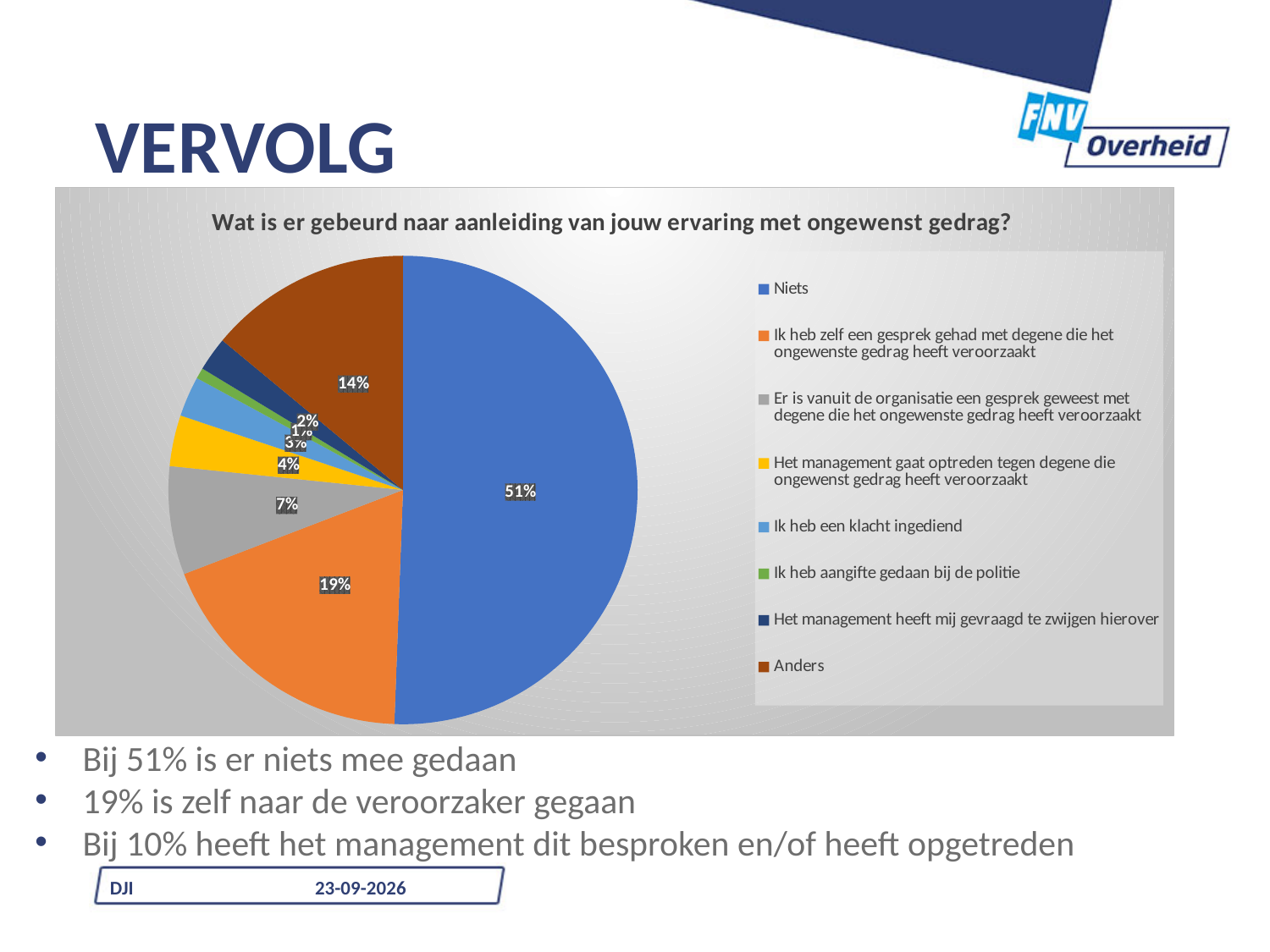
What percentage of the pie is 'Niets'? 51% How many categories does the legend of the pie chart list? 8 What is the title of the chart? Wat is er gebeurd naar aanleiding van jouw ervaring met ongewenst gedrag? What percentage is shown for 'Het management gaat optreden tegen degene die ongewenst gedrag heeft veroorzaakt'? 4% What percentage is shown for 'Ik heb zelf een gesprek gehad met degene die het ongewenste gedrag heeft veroorzaakt'? 19% Which category has the largest share of the pie? Niets What percentage is shown for 'Er is vanuit de organisatie een gesprek geweest met degene die het ongewenste gedrag heeft veroorzaakt'? 7% What is the difference in percentage points between 'Niets' and 'Ik heb zelf een gesprek gehad met degene die het ongewenste gedrag heeft veroorzaakt'? 32 What percentage is shown for 'Het management heeft mij gevraagd te zwijgen hierover'? 2% Which has a larger share: 'Anders' or 'Er is vanuit de organisatie een gesprek geweest met degene die het ongewenste gedrag heeft veroorzaakt'? Anders What percentage is shown for 'Anders'? 14% What kind of chart is shown on the slide? pie chart